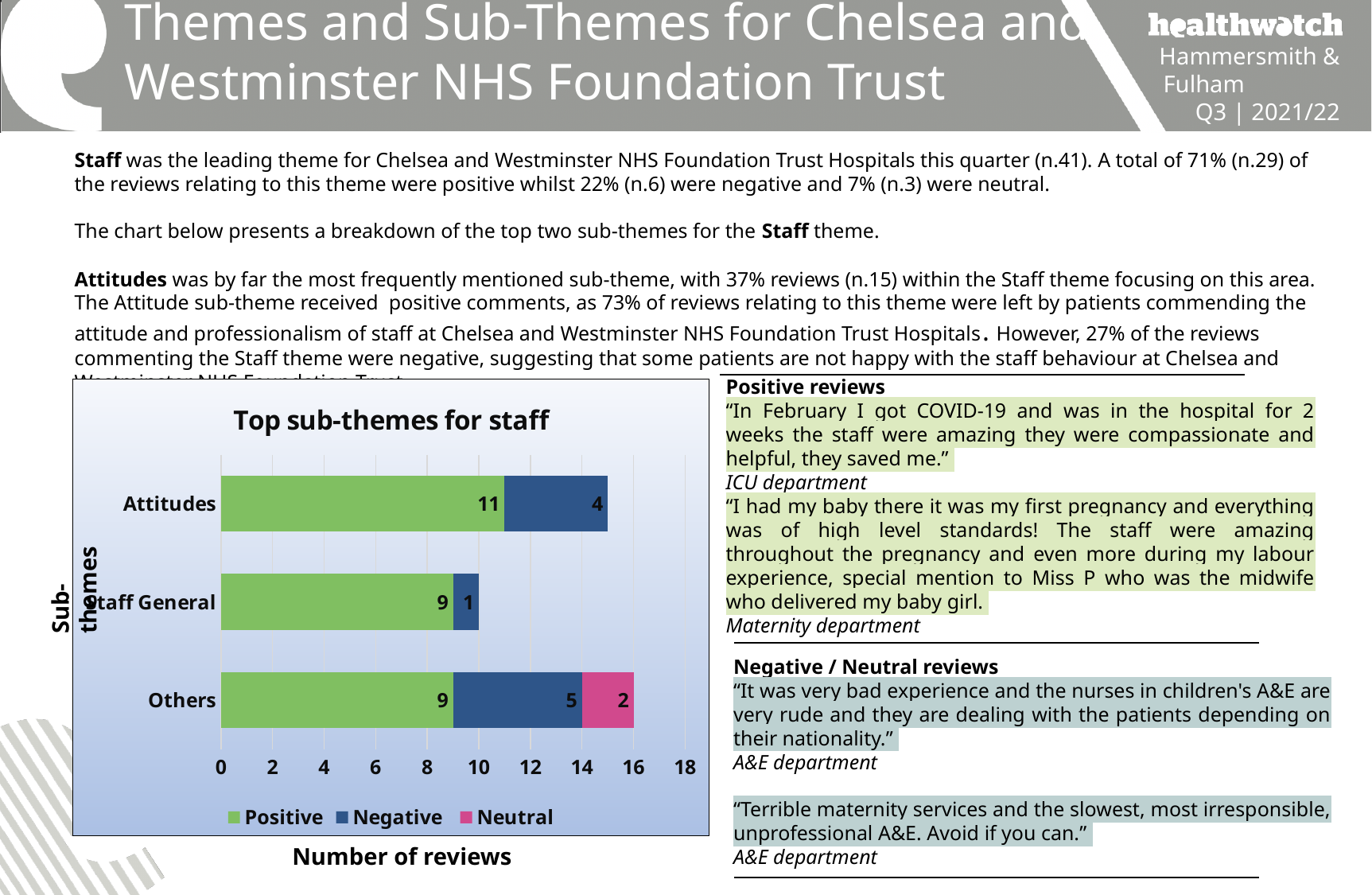
How many sub-theme categories are shown in the "Top sub-themes for staff" chart? 3 Which sub-theme has the lowest Negative value in the "Top sub-themes for staff" chart? Staff General What is the Negative value for Others in the "Top sub-themes for staff" chart? 5 What is the difference between the Positive values for Attitudes and Staff General in the "Top sub-themes for staff" chart? 2 Which sub-theme has the highest Positive value in the "Top sub-themes for staff" chart? Attitudes What is the Positive value for Attitudes in the "Top sub-themes for staff" chart? 11 What type of chart is "Top sub-themes for staff"? Stacked bar chart What is the Negative value for Staff General in the "Top sub-themes for staff" chart? 1 What is the total number of reviews for Others in the "Top sub-themes for staff" chart? 16 What is the Neutral value for Others in the "Top sub-themes for staff" chart? 2 What is the x-axis label of the "Top sub-themes for staff" chart? Number of reviews How many series does the legend of the "Top sub-themes for staff" chart list? 3